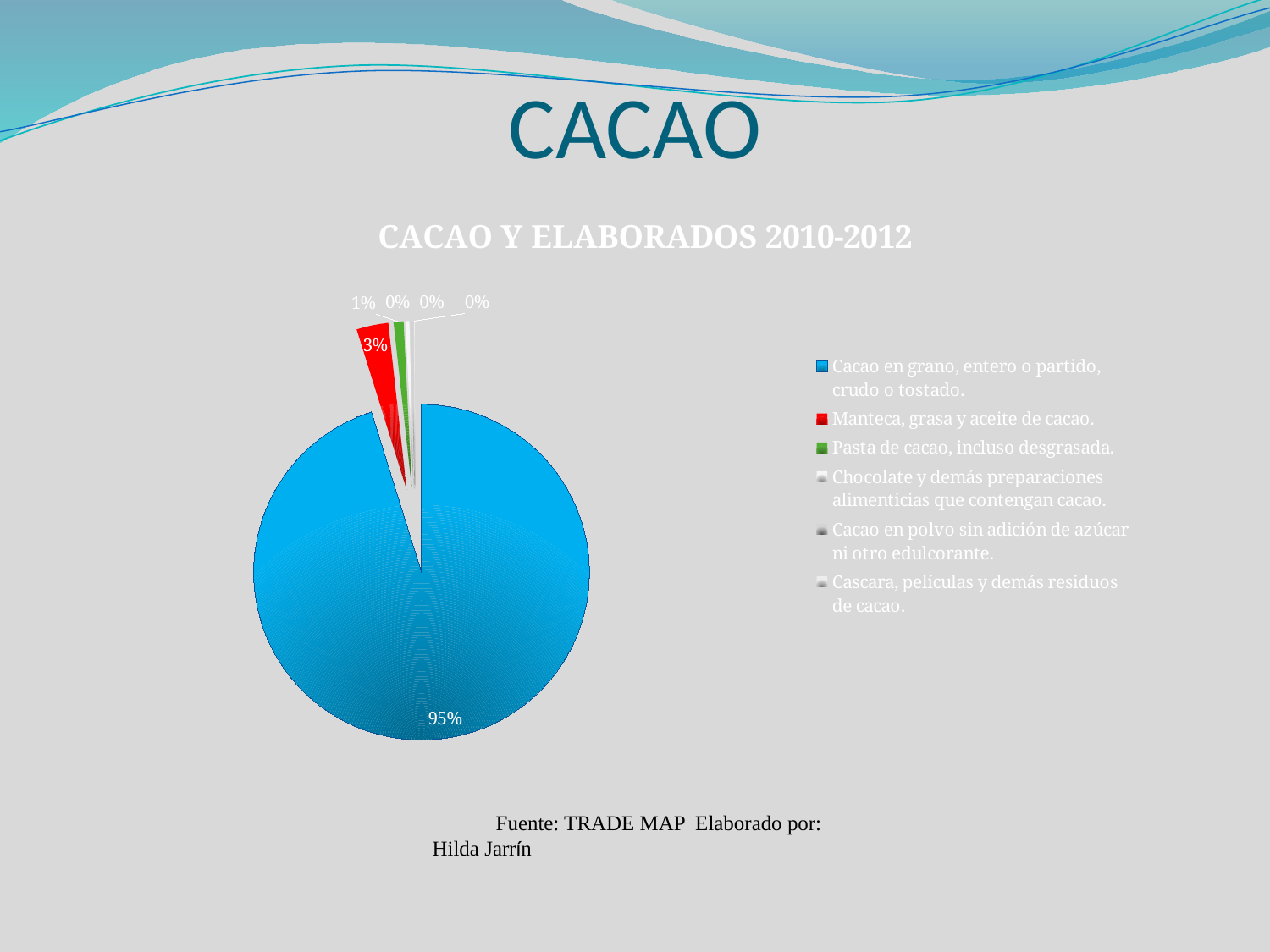
Which is larger, the share for "Manteca, grasa y aceite de cacao." or the share for "Pasta de cacao, incluso desgrasada."? Manteca, grasa y aceite de cacao. What percentage is shown for "Pasta de cacao, incluso desgrasada."? 1% What is the difference in percentage points between "Manteca, grasa y aceite de cacao." and "Pasta de cacao, incluso desgrasada."? 2% What is the difference in percentage points between "Cacao en grano, entero o partido, crudo o tostado." and "Manteca, grasa y aceite de cacao."? 92% What share of the pie does "Cacao en grano, entero o partido, crudo o tostado." represent? 95% What kind of chart is shown on the slide? pie chart What percentage is shown for "Manteca, grasa y aceite de cacao."? 3% Which category has the largest slice of the pie? Cacao en grano, entero o partido, crudo o tostado. What percentage is shown for "Chocolate y demás preparaciones alimenticias que contengan cacao."? 0% How many categories does the legend list? 6 What is the title of the chart? CACAO Y ELABORADOS 2010-2012 What colour is the largest slice of the pie? blue